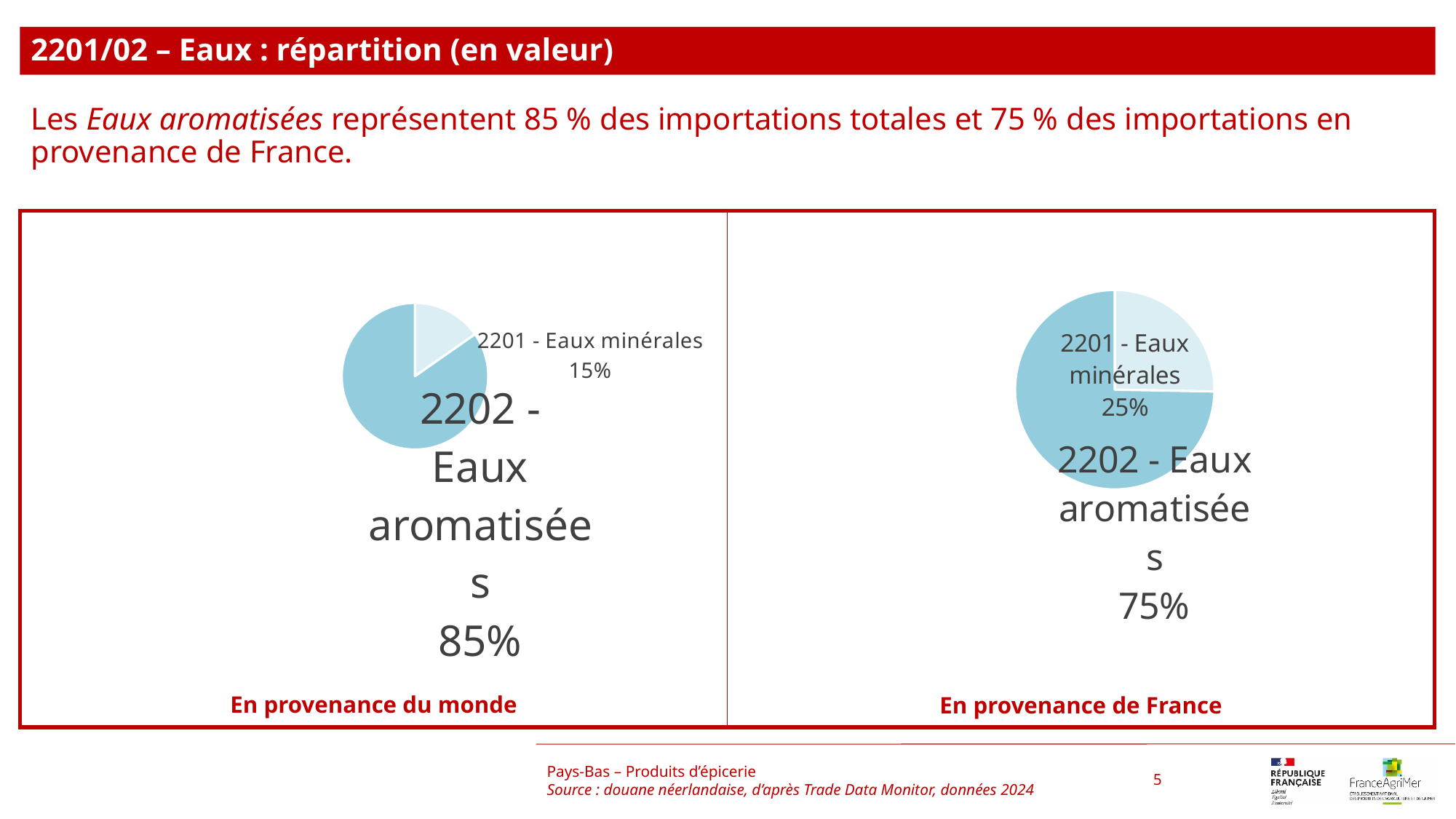
Is the share of 2201 - Eaux minérales larger in the 'En provenance du monde' chart or in the 'En provenance de France' chart? En provenance de France In the 'En provenance de France' chart, what is the difference between the shares of 2202 - Eaux aromatisées and 2201 - Eaux minérales? 50 percentage points How many slices does the 'En provenance de France' pie chart have? 2 What is the title of the chart on the right side of the slide? En provenance de France What kind of chart is the 'En provenance du monde' chart? Pie chart In the 'En provenance de France' chart, which category has the smallest slice? 2201 - Eaux minérales In the 'En provenance de France' chart, what share does 2202 - Eaux aromatisées have? 75% In the 'En provenance du monde' chart, what share does 2202 - Eaux aromatisées have? 85% In the 'En provenance de France' chart, what share does 2201 - Eaux minérales have? 25% In the 'En provenance du monde' chart, which category has the largest slice? 2202 - Eaux aromatisées In the 'En provenance du monde' chart, what is the difference between the shares of 2202 - Eaux aromatisées and 2201 - Eaux minérales? 70 percentage points